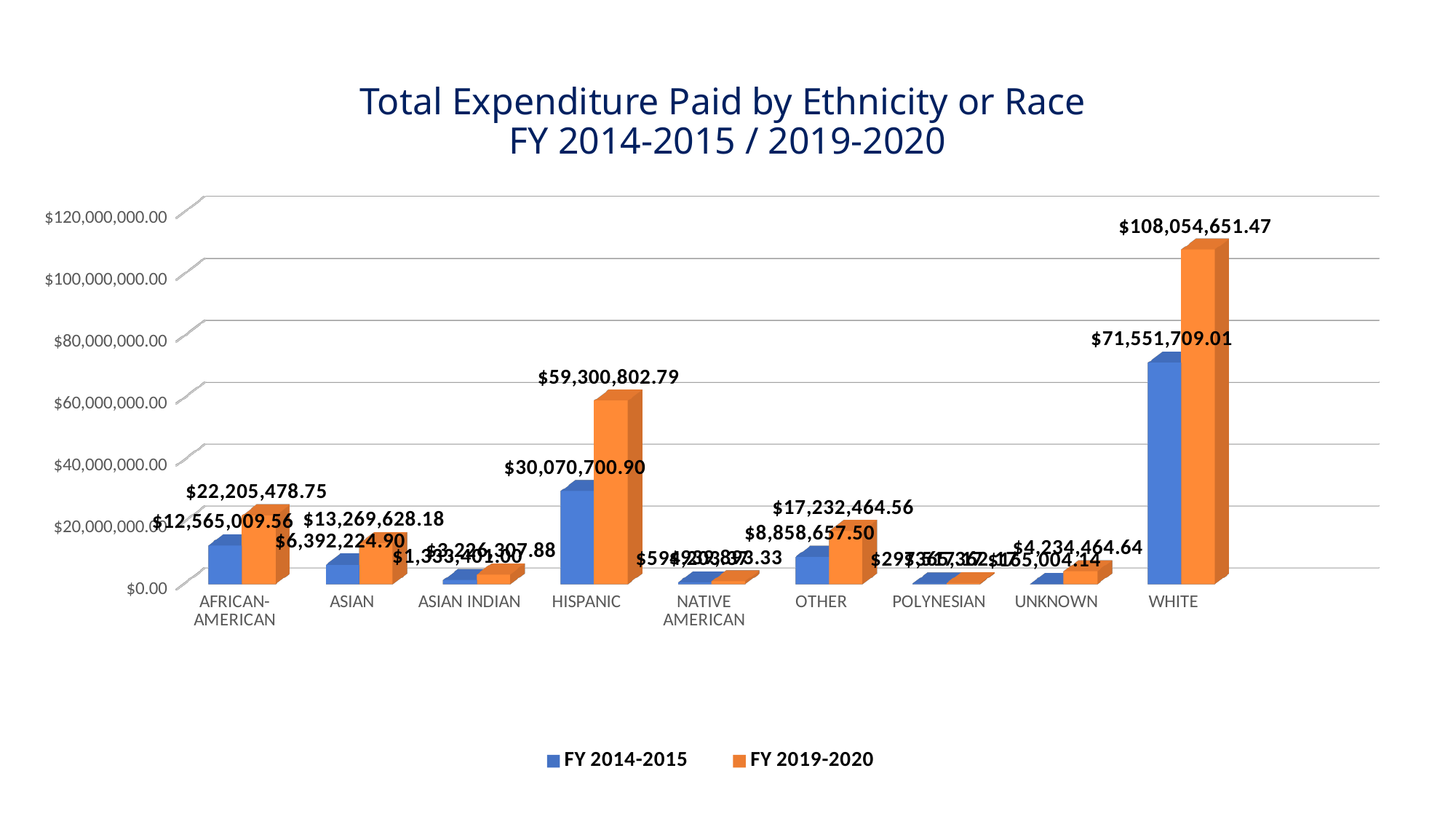
How many categories are shown on the x axis? 9 What is the difference between the FY 2019-2020 and FY 2014-2015 values for AFRICAN-AMERICAN? $9,640,469.19 What is the FY 2014-2015 value for HISPANIC? $30,070,700.90 Which category has the highest FY 2019-2020 value? WHITE Is the FY 2014-2015 value for WHITE greater or less than $80,000,000.00? less What kind of chart is shown on the slide? bar chart Which is larger: the FY 2019-2020 value for HISPANIC or the FY 2019-2020 value for AFRICAN-AMERICAN? HISPANIC What is the FY 2014-2015 value for ASIAN? $6,392,224.90 How many series does the legend list? 2 What is the difference between the FY 2019-2020 and FY 2014-2015 values for WHITE? $36,502,942.46 What is the FY 2019-2020 value for WHITE? $108,054,651.47 What is the FY 2019-2020 value for OTHER? $17,232,464.56